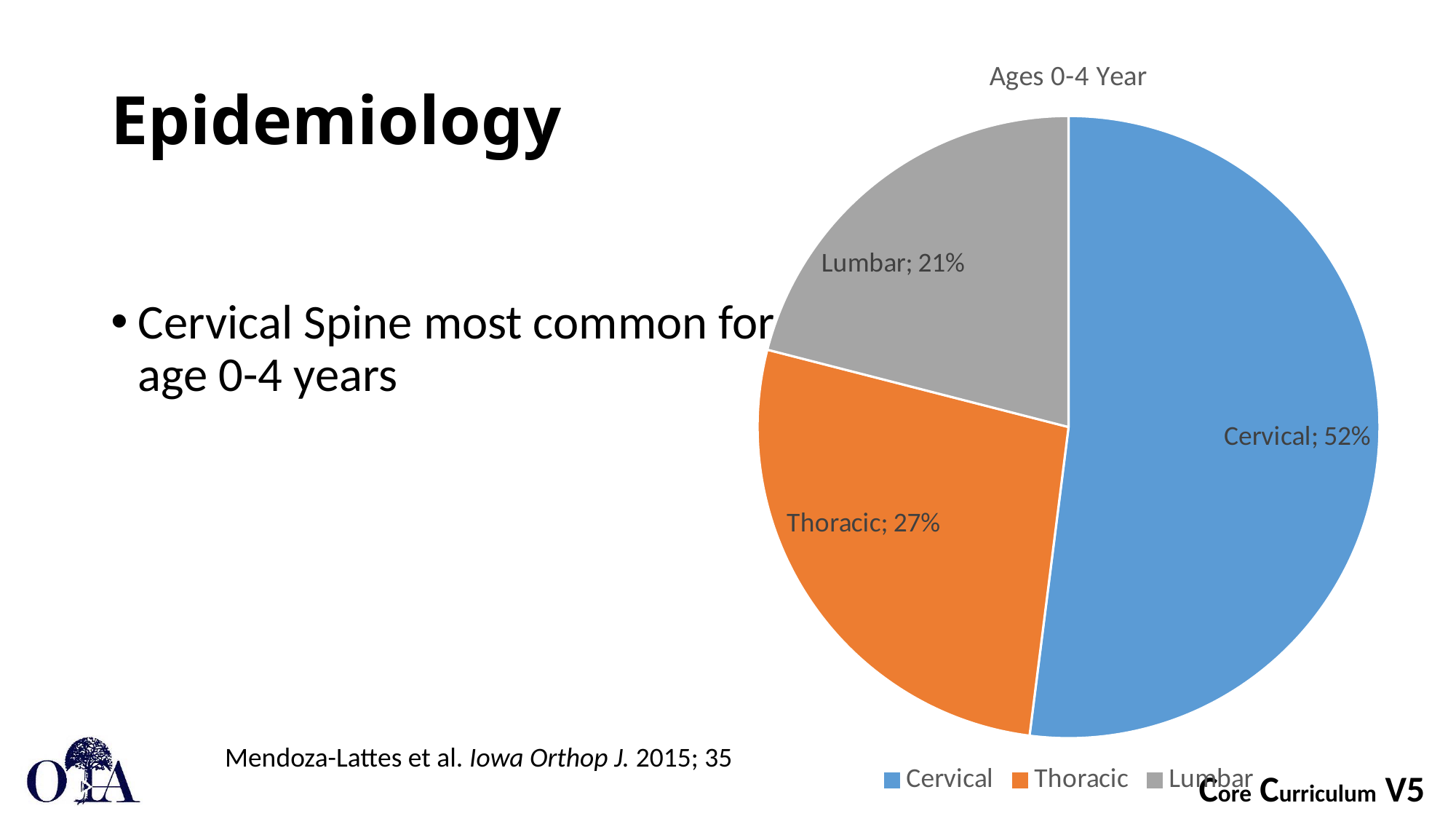
How many slices does the pie chart have? 3 What percentage of the pie is Cervical? 52% Which is larger, the Thoracic share or the Lumbar share? Thoracic Which category has the largest share of the pie? Cervical What percentage of the pie is Lumbar? 21% What percentage of the pie is Thoracic? 27% What type of chart is shown on the slide? pie chart What is the difference in percentage points between Cervical and Thoracic? 25 What is the difference in percentage points between Thoracic and Lumbar? 6 What is the title of the chart? Ages 0-4 Year Which category has the smallest share of the pie? Lumbar What colour is the Thoracic slice? orange